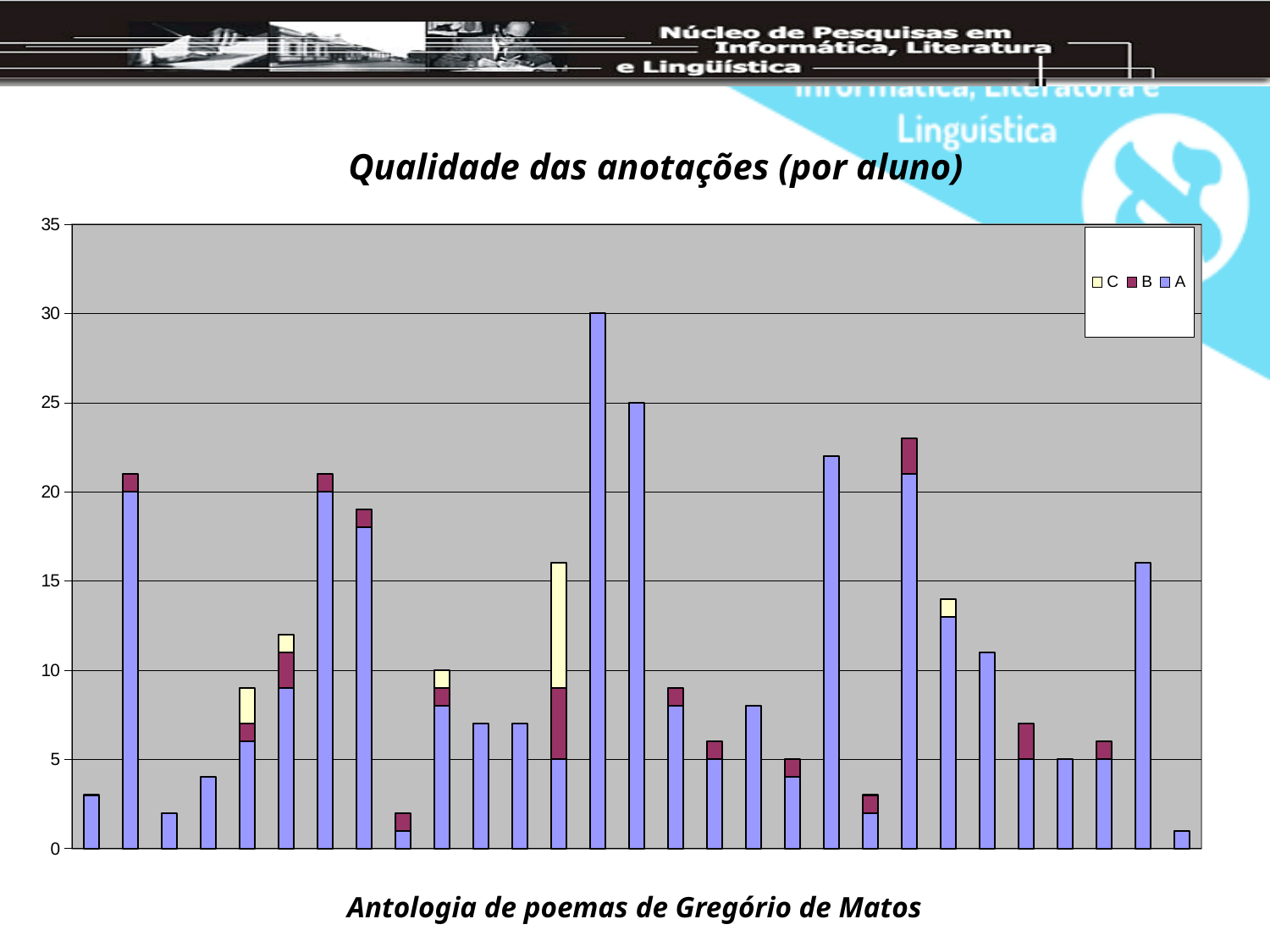
Which series forms the bottom segment of every bar? A What is the title of the chart? Qualidade das anotações (por aluno) Is the tallest bar made up of a single series or several series? A single series (A) Is the value of the shortest bar greater or less than 5? less How many series does the legend list? 3 Is the value of the tallest bar greater or less than 25? greater How many bars are plotted in the chart? 29 What are the legend entries of the chart? C, B, A What kind of chart is shown on the slide? Stacked bar chart What value does the second-tallest bar in the chart reach? 25 Which series appears in the fewest bars? C What value does the tallest bar in the chart reach? 30